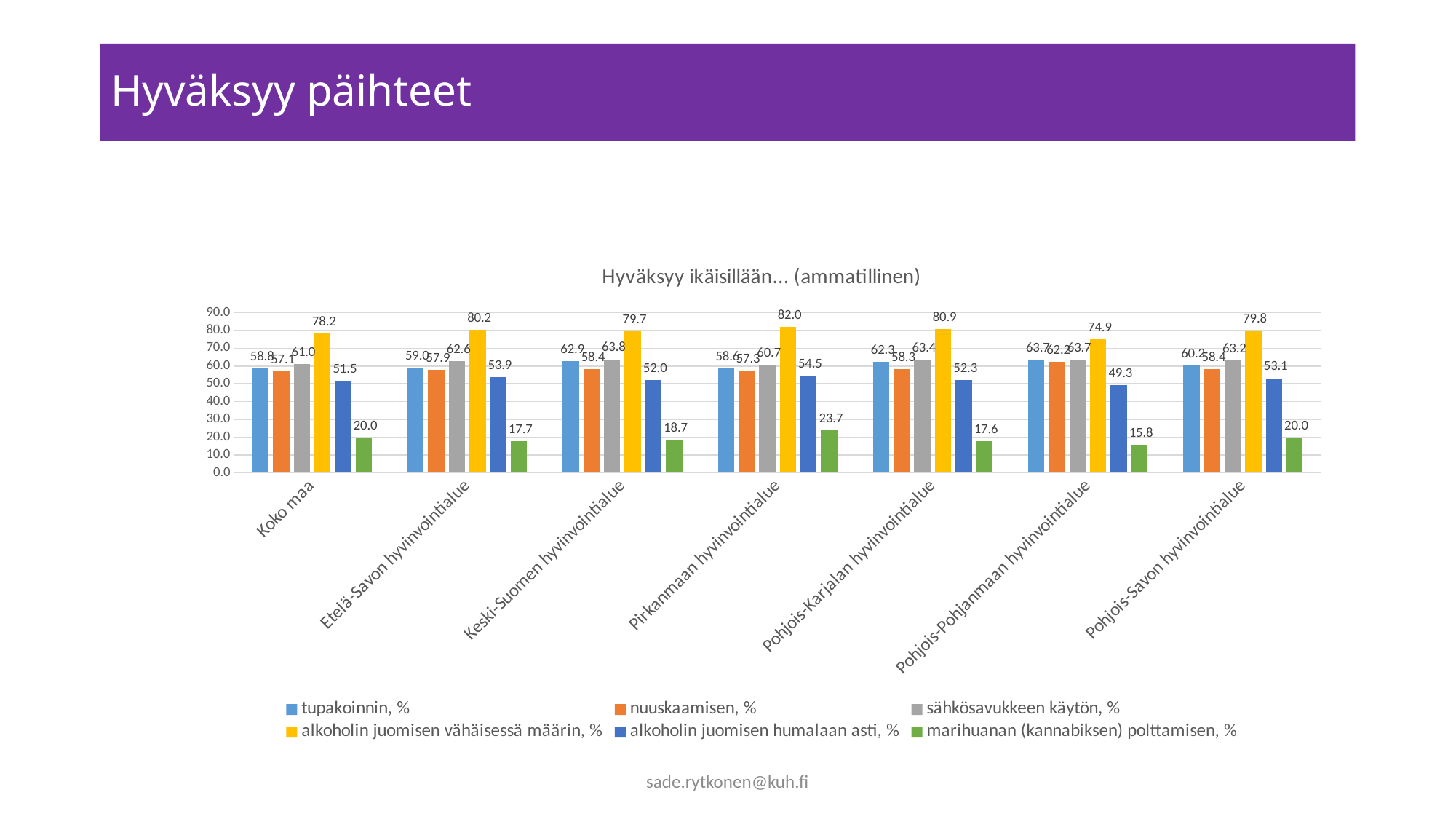
What is the difference between the 'marihuanan (kannabiksen) polttamisen, %' values for Pirkanmaan hyvinvointialue and Pohjois-Pohjanmaan hyvinvointialue? 7.9 What is the value for 'alkoholin juomisen vähäisessä määrin, %' for Pirkanmaan hyvinvointialue? 82.0 How many series does the legend list? 6 Which category has the highest value for 'alkoholin juomisen vähäisessä määrin, %'? Pirkanmaan hyvinvointialue Which category has the lowest value for 'alkoholin juomisen vähäisessä määrin, %'? Pohjois-Pohjanmaan hyvinvointialue Which category has the highest value for 'marihuanan (kannabiksen) polttamisen, %'? Pirkanmaan hyvinvointialue For 'alkoholin juomisen humalaan asti, %', which is larger: Pirkanmaan hyvinvointialue or Pohjois-Pohjanmaan hyvinvointialue? Pirkanmaan hyvinvointialue Is the value for 'marihuanan (kannabiksen) polttamisen, %' for Pirkanmaan hyvinvointialue greater or less than 20.0? greater How many categories are shown on the x axis of the chart? 7 What kind of chart is shown on the slide? bar chart What is the value for 'alkoholin juomisen humalaan asti, %' for Koko maa? 51.5 What is the value for 'marihuanan (kannabiksen) polttamisen, %' for Pohjois-Pohjanmaan hyvinvointialue? 15.8